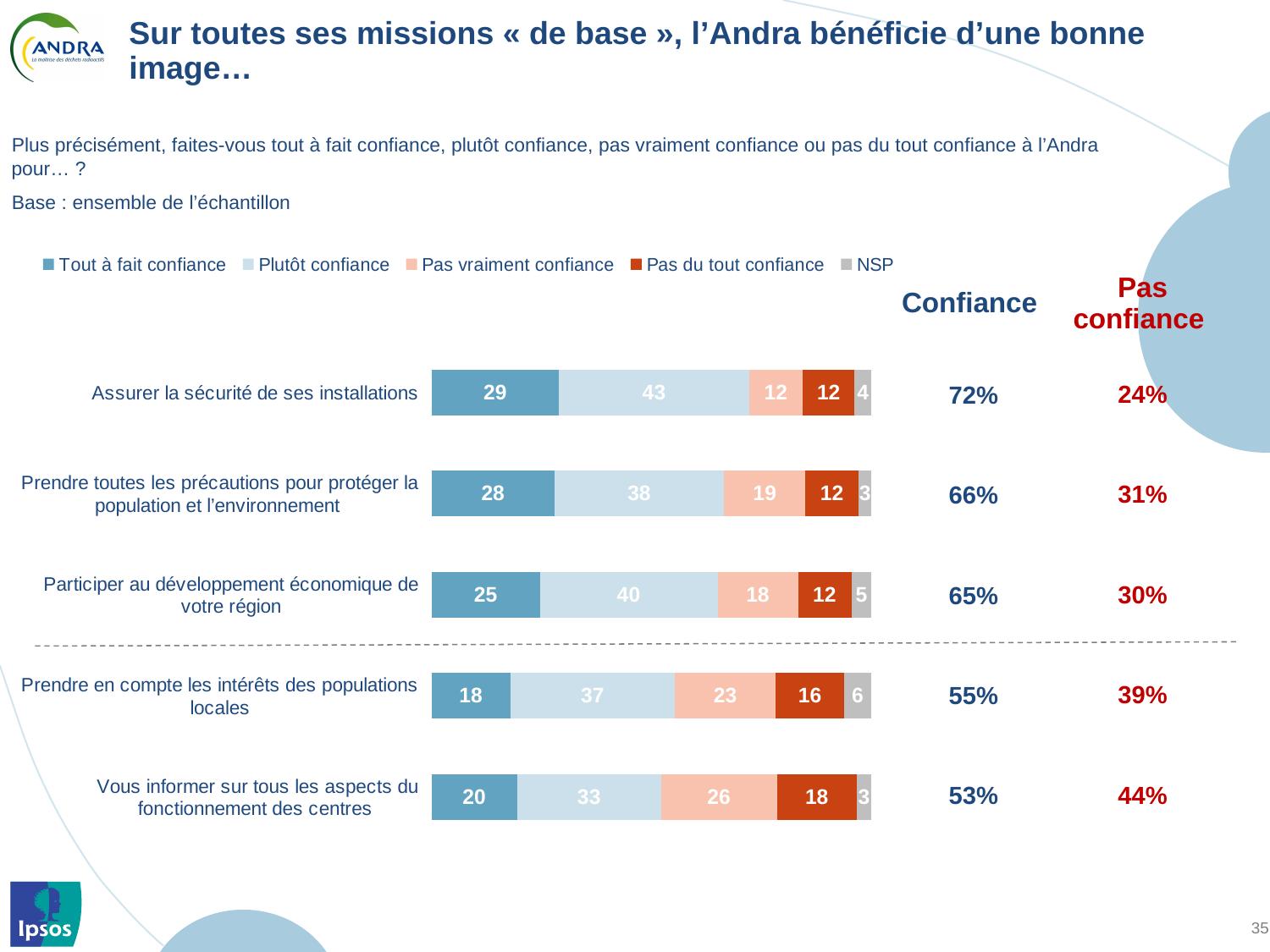
Which category has the highest "Tout à fait confiance" value? Assurer la sécurité de ses installations What is the "Plutôt confiance" value for "Participer au développement économique de votre région"? 40 How many categories are shown in the chart? 5 How many series does the legend list? 5 What kind of chart is shown on the slide? Stacked bar chart What is the NSP value for "Prendre en compte les intérêts des populations locales"? 6 Which category has the lowest "Plutôt confiance" value? Vous informer sur tous les aspects du fonctionnement des centres What is the "Pas du tout confiance" value for "Vous informer sur tous les aspects du fonctionnement des centres"? 18 Which is larger: the "Pas du tout confiance" value for "Prendre en compte les intérêts des populations locales" or for "Participer au développement économique de votre région"? Prendre en compte les intérêts des populations locales What is the difference between the "Pas vraiment confiance" values for "Vous informer sur tous les aspects du fonctionnement des centres" and "Assurer la sécurité de ses installations"? 14 What is the total of the stacked bar for "Prendre toutes les précautions pour protéger la population et l'environnement"? 100 What is the "Tout à fait confiance" value for "Assurer la sécurité de ses installations"? 29